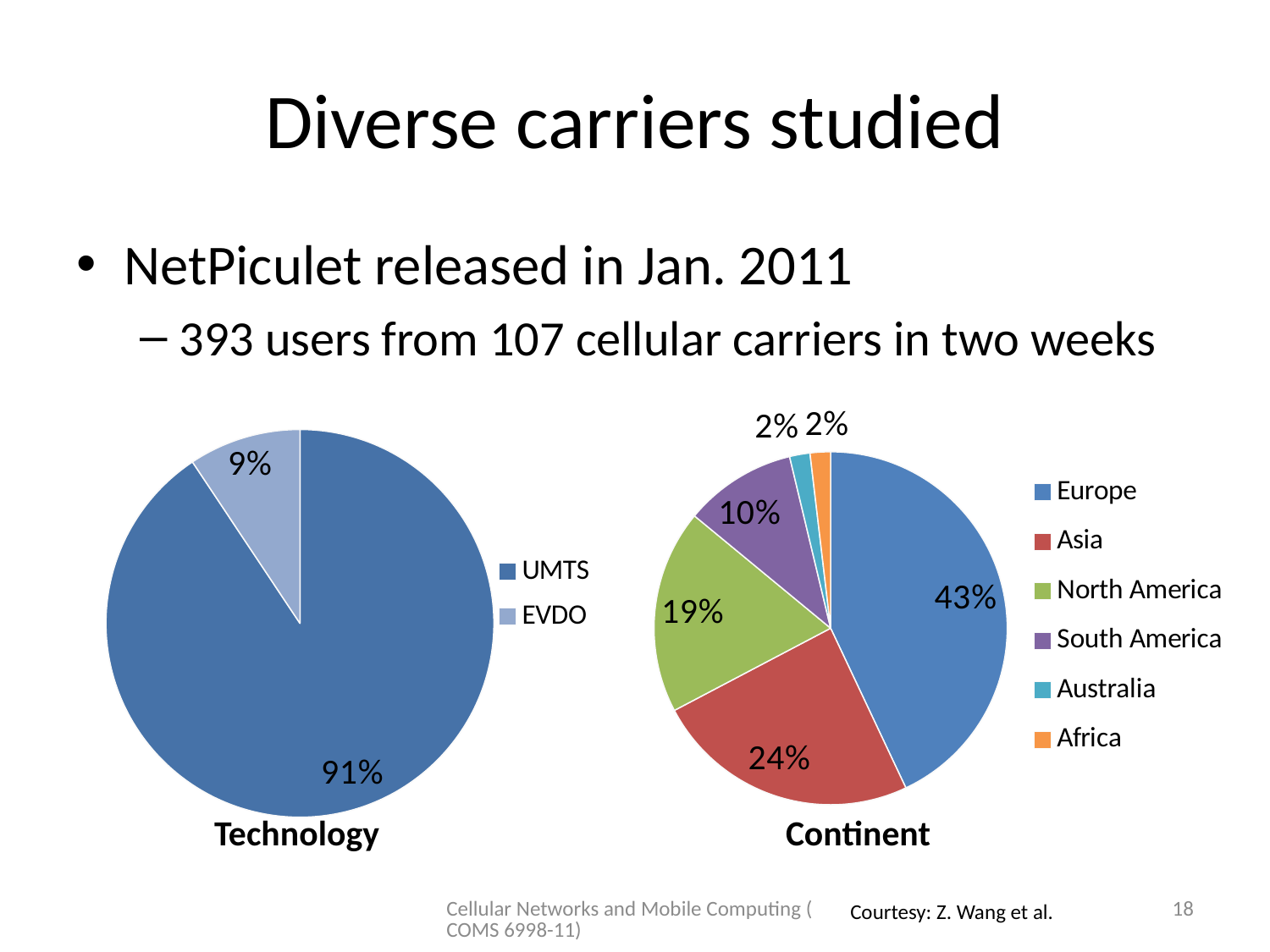
In the Technology chart, what share of the pie is UMTS? 91% In the Continent chart, what share of the pie is North America? 19% In the Technology chart, what share of the pie is EVDO? 9% How many categories does the legend of the Continent chart list? 6 In the Technology chart, which technology has the smallest share? EVDO In the Continent chart, what is the difference between the Europe and Asia shares? 19% In the Continent chart, which continent has the largest share? Europe In the Continent chart, which is larger, the share for North America or the share for South America? North America What kind of chart is the Technology chart? Pie chart